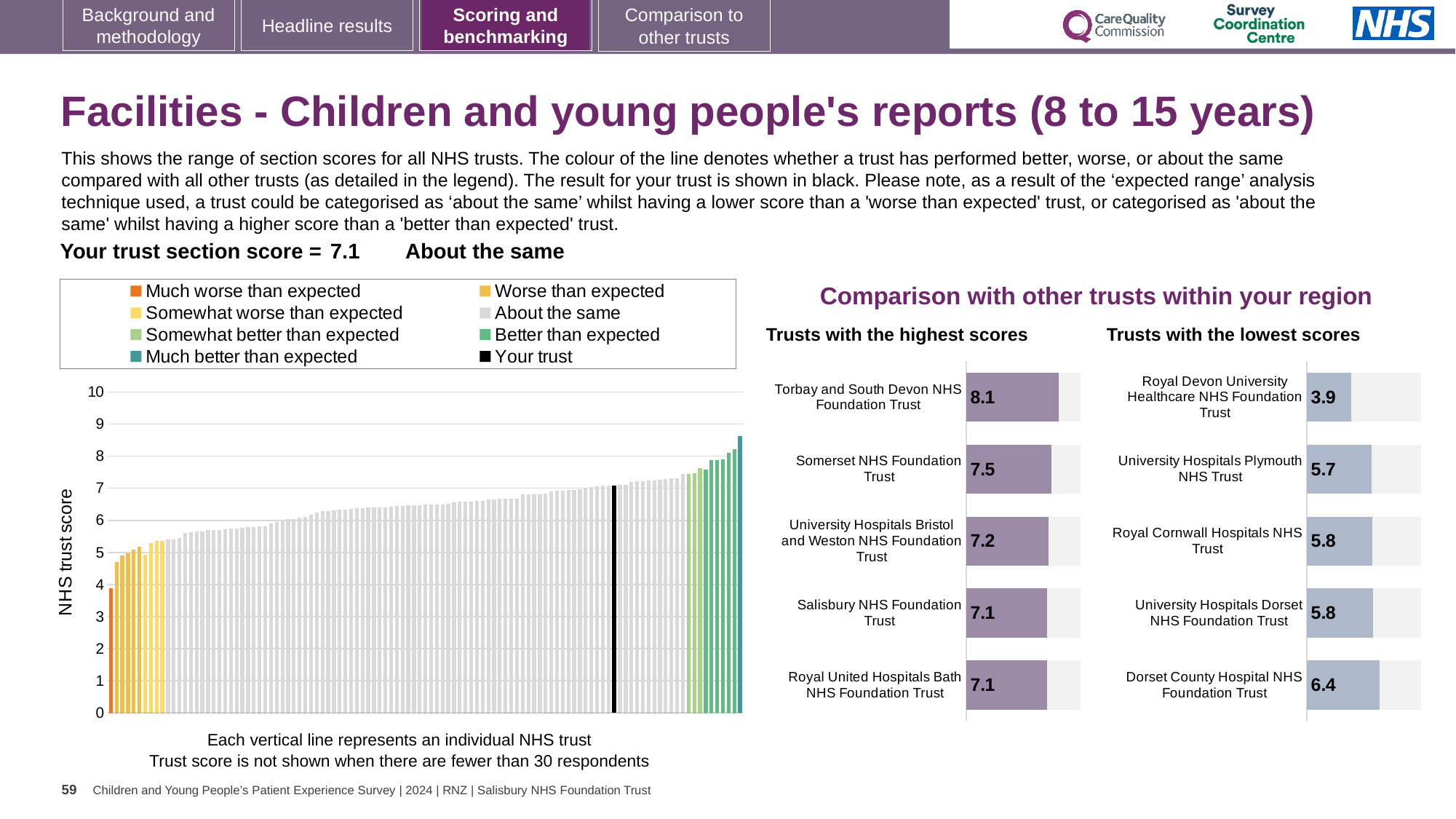
In the 'Trusts with the highest scores' chart, what is the difference between the scores of Torbay and South Devon NHS Foundation Trust and Somerset NHS Foundation Trust? 0.6 What kind of chart is the main 'NHS trust score' chart on the left? Bar chart In the 'Trusts with the highest scores' chart, which trust has the highest score? Torbay and South Devon NHS Foundation Trust In the 'Trusts with the lowest scores' chart, what is the score for Royal Devon University Healthcare NHS Foundation Trust? 3.9 In the main 'NHS trust score' chart, is the value of the tallest bar greater or less than 8? greater In the 'Trusts with the lowest scores' chart, which trust has the lowest score? Royal Devon University Healthcare NHS Foundation Trust In the main 'NHS trust score' chart, what is the score of the black bar representing your trust? 7.1 In the 'Trusts with the lowest scores' chart, how much higher is Dorset County Hospital NHS Foundation Trust's score than Royal Devon University Healthcare NHS Foundation Trust's score? 2.5 How many trusts are shown in the 'Trusts with the lowest scores' chart? 5 In the 'Trusts with the highest scores' chart, what is the score for Torbay and South Devon NHS Foundation Trust? 8.1 How many entries does the legend of the main 'NHS trust score' chart list? 8 In the 'Trusts with the highest scores' chart, which has the larger score: Somerset NHS Foundation Trust or University Hospitals Bristol and Weston NHS Foundation Trust? Somerset NHS Foundation Trust